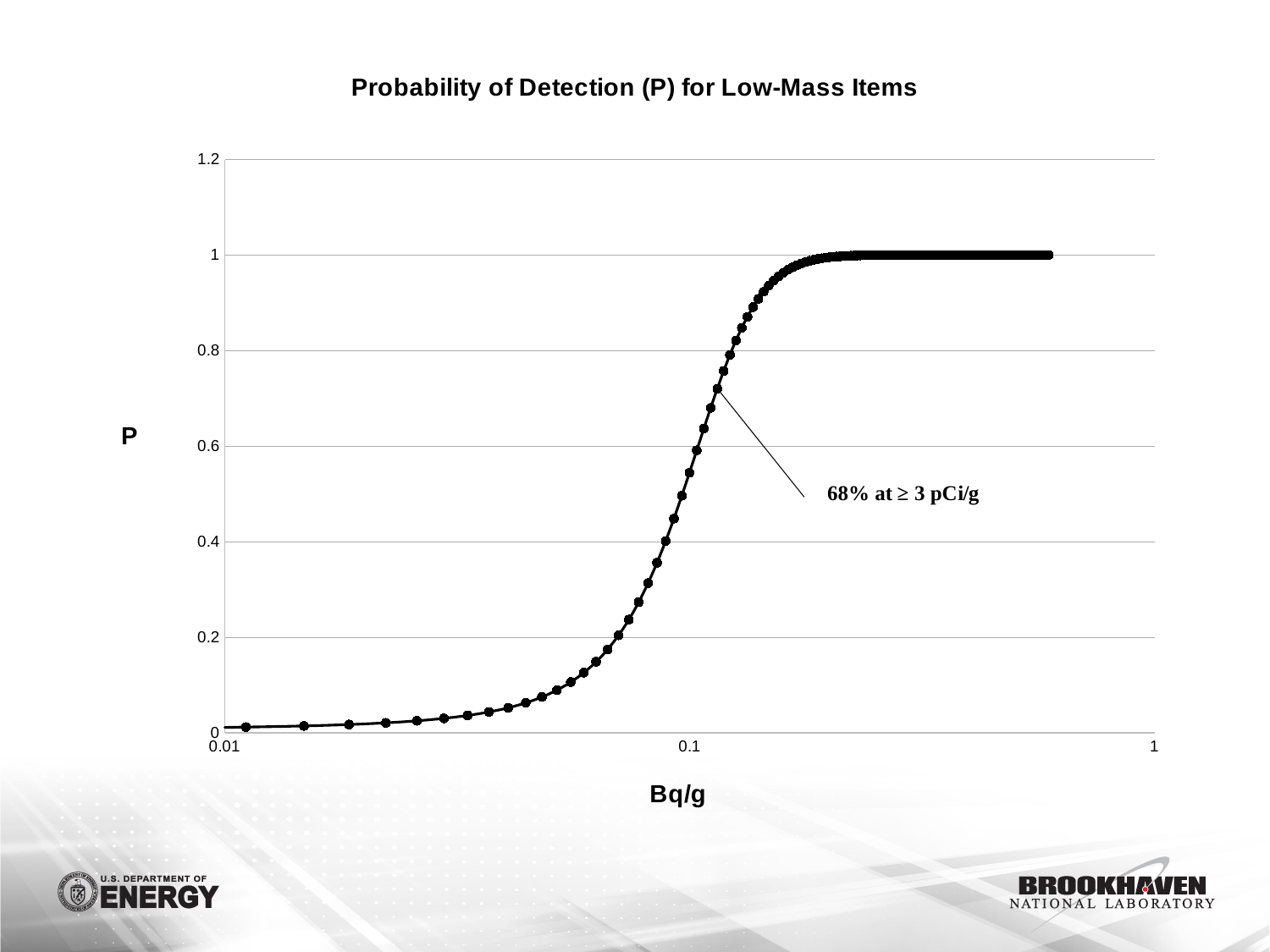
At what value of P does the curve level off at high Bq/g? 1 Does the probability of detection rise or fall as Bq/g increases along the x axis? rise What does the annotation on the curve say? 68% at ≥ 3 pCi/g What is the highest tick value shown on the y axis? 1.2 Which is larger, the value of P at 0.01 Bq/g or at 0.1 Bq/g? 0.1 Bq/g What is the title of the chart? Probability of Detection (P) for Low-Mass Items Is the value of P near 1 Bq/g greater or less than 0.8? greater Is the value of P at 0.01 Bq/g greater or less than 0.2? less Is the value of P at 0.1 Bq/g greater or less than 0.4? greater What kind of chart is shown on the slide? line chart What is the label of the x axis? Bq/g